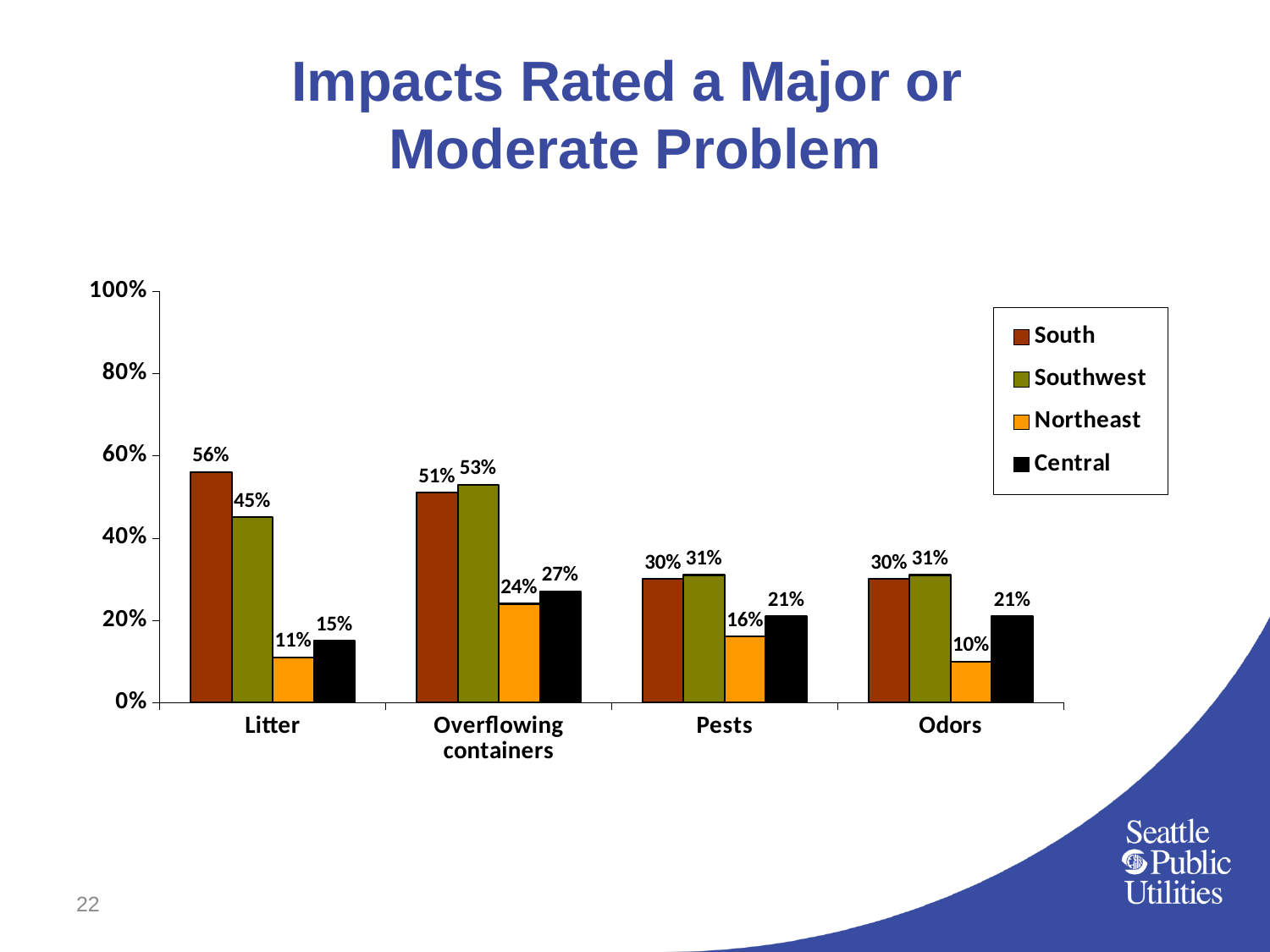
Which category has the lowest value for the South series? Pests and Odors (both 30%) Which is larger for Overflowing containers: the South value or the Southwest value? Southwest What is the title of the slide? Impacts Rated a Major or Moderate Problem What is the value for South in the Litter category? 56% How many categories are shown on the x axis? 4 What kind of chart is shown on the slide? Bar chart What is the value for Southwest in the Pests category? 31% How many series does the legend list? 4 What is the value for Northeast in the Odors category? 10% What is the value for Central in the Overflowing containers category? 27% Which category has the highest value for the Northeast series? Overflowing containers What is the difference between the South and Northeast values for Litter? 45%